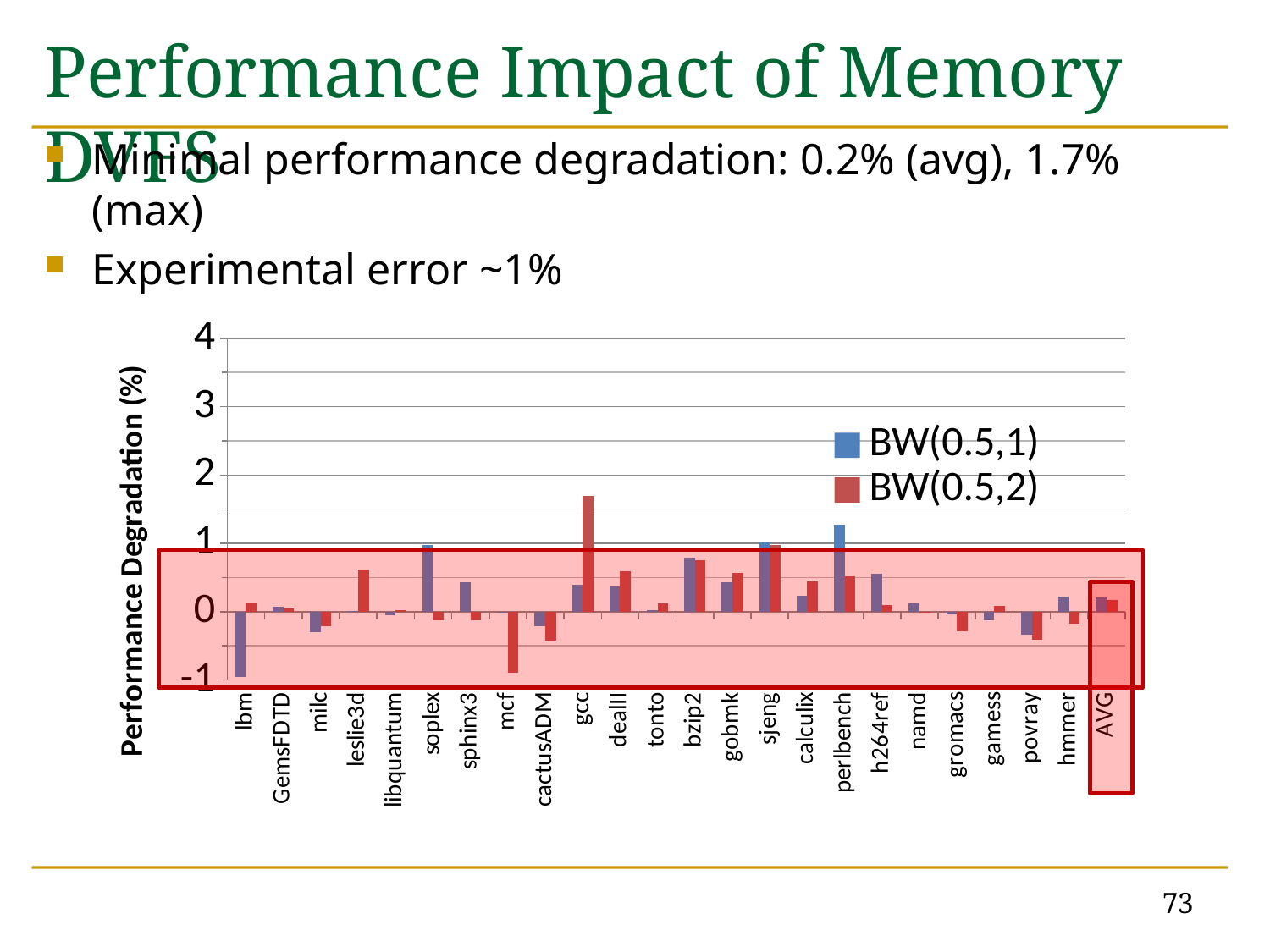
How many series does the chart legend list? 2 Is the BW(0.5,2) value for gcc greater or less than 1? greater What kind of chart is shown on the slide? bar chart Which category has the highest BW(0.5,1) value? perlbench What is the label of the y axis of the chart? Performance Degradation (%) How many categories are shown along the x axis of the chart? 24 Which category has the lowest BW(0.5,1) value? lbm For gcc, which series has the larger value, BW(0.5,1) or BW(0.5,2)? BW(0.5,2) Is the BW(0.5,1) value for lbm greater or less than 0? less Which two series are listed in the chart legend? BW(0.5,1) and BW(0.5,2) Which category has the highest BW(0.5,2) value? gcc Which category has the lowest BW(0.5,2) value? mcf